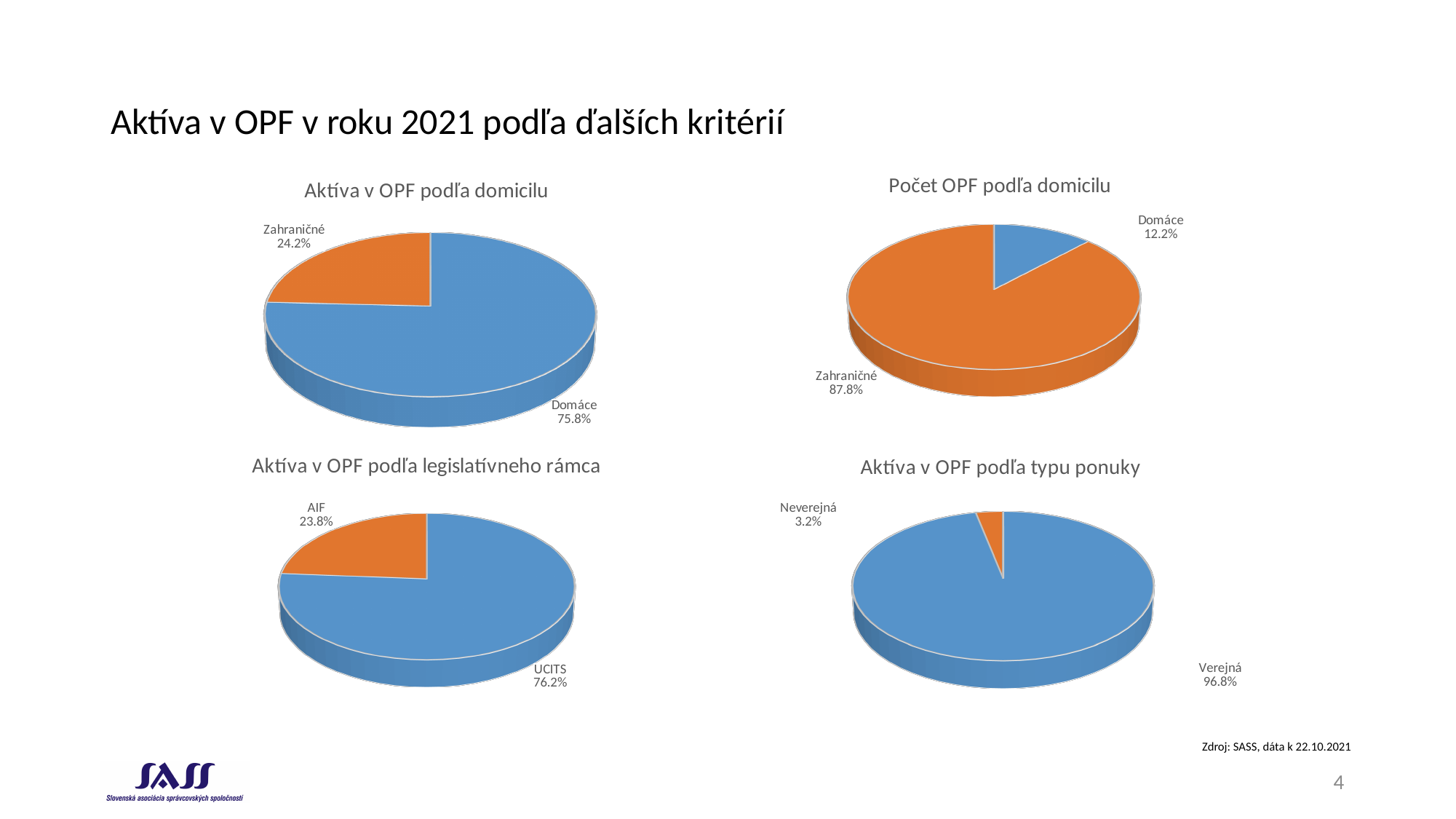
In the chart 'Počet OPF podľa domicilu', which category has the largest slice? Zahraničné In the chart 'Aktíva v OPF podľa typu ponuky', what is the difference between the Verejná and Neverejná shares? 93.6% In the chart 'Aktíva v OPF podľa legislatívneho rámca', which category has the smallest slice? AIF In the chart 'Počet OPF podľa domicilu', what share does Zahraničné have? 87.8% How many slices does the chart 'Počet OPF podľa domicilu' have? 2 How many charts are shown on the slide? 4 In the chart 'Aktíva v OPF podľa domicilu', what share does Zahraničné have? 24.2% In the chart 'Aktíva v OPF podľa domicilu', what share does Domáce have? 75.8% In the chart 'Aktíva v OPF podľa domicilu', which is larger, Domáce or Zahraničné? Domáce In the chart 'Aktíva v OPF podľa typu ponuky', what share does Neverejná have? 3.2% What kind of chart is 'Aktíva v OPF podľa typu ponuky'? Pie chart In the chart 'Aktíva v OPF podľa legislatívneho rámca', what share does AIF have? 23.8%